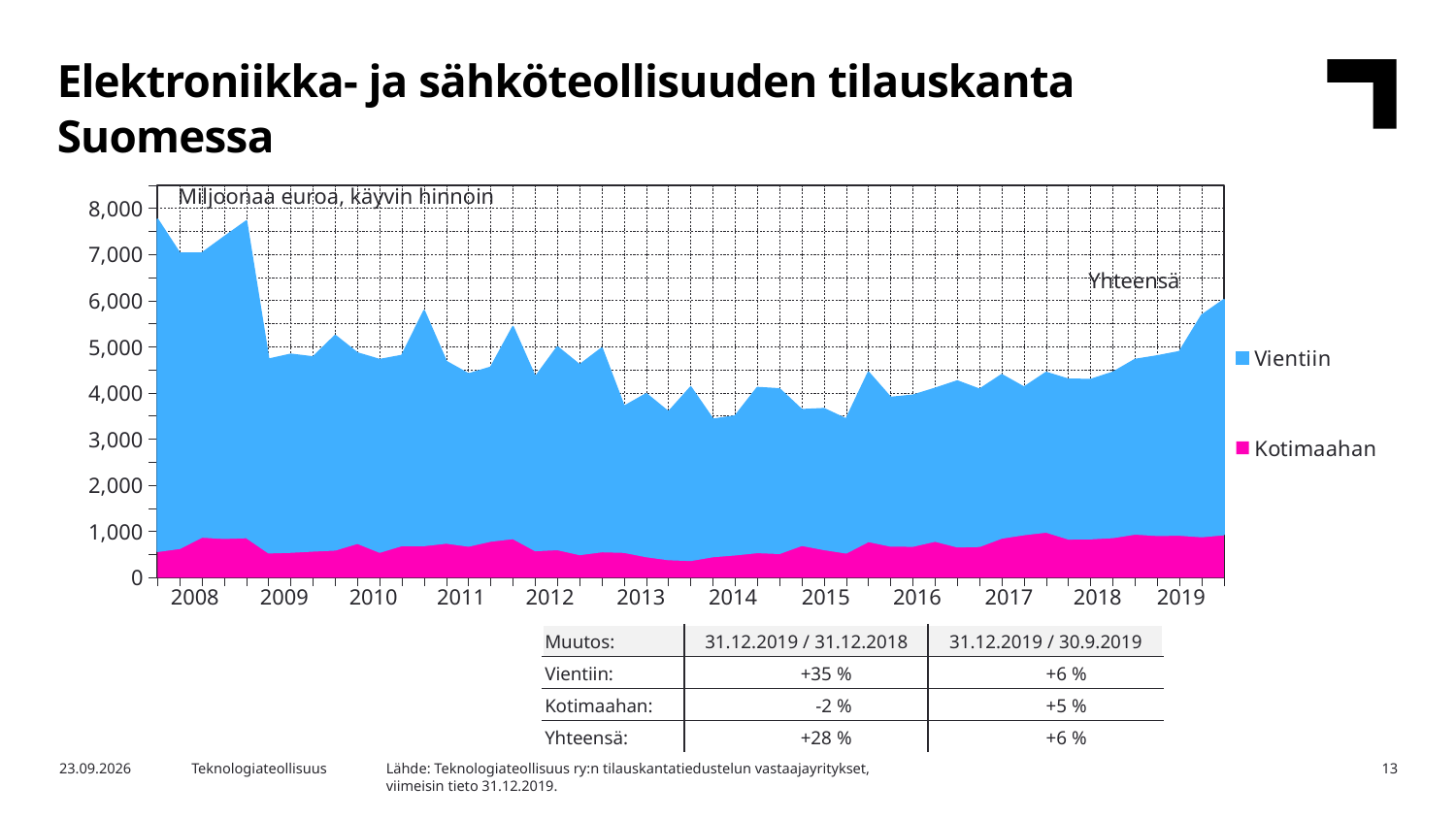
How many year labels are shown on the x axis? 12 Which series is larger throughout the chart, Vientiin or Kotimaahan? Vientiin Is the total order stock at the start of 2008 greater or less than 7,000? greater Is the Kotimaahan value in 2014 greater or less than 1,000? less In which year does the total order stock reach its highest level? 2008 What kind of chart is shown on the slide? Stacked area chart Does the total order stock rise or fall from 2008 to 2014? fall How many series does the legend list? 2 Which two series are listed in the legend? Vientiin and Kotimaahan What unit is stated at the top of the chart? Miljoonaa euroa, käyvin hinnoin Is the total order stock in 2010 greater or less than 4,000? greater